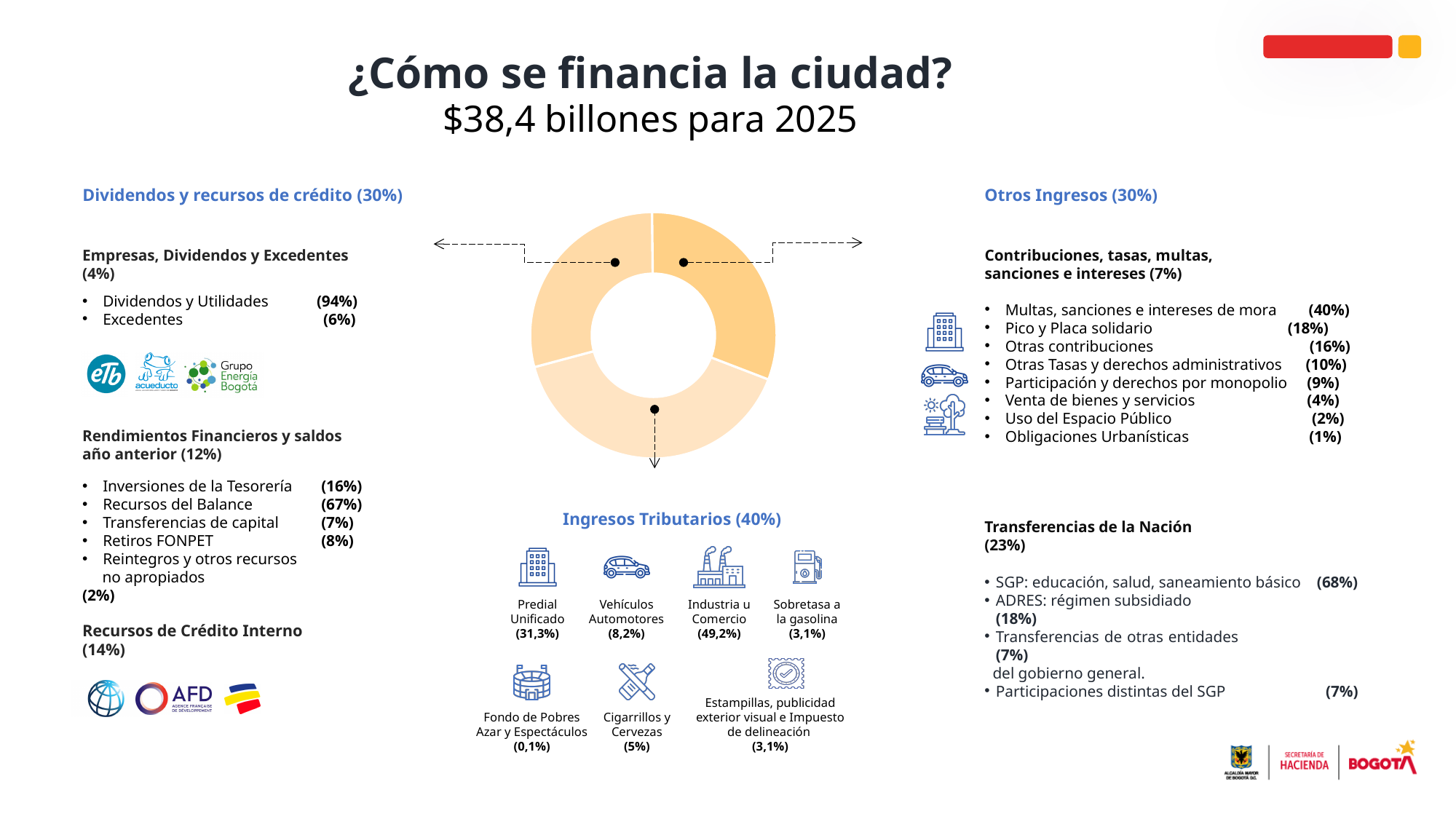
What is the title of the slide containing the donut chart? ¿Cómo se financia la ciudad? What kind of chart is shown in the centre of the slide? Pie chart (donut) How many slices does the donut chart have? 3 What share of the donut chart does Otros Ingresos represent? 30% Which slice of the donut chart is the largest? Ingresos Tributarios What share of the donut chart does Dividendos y recursos de crédito represent? 30% Which is larger in the donut chart, Ingresos Tributarios or Otros Ingresos? Ingresos Tributarios What total amount does the subtitle above the donut chart state for 2025? $38,4 billones Do the Otros Ingresos and Dividendos y recursos de crédito slices have the same share of the donut chart? Yes, both 30% What share of the donut chart does Ingresos Tributarios represent? 40% What is the difference in percentage points between the Ingresos Tributarios slice and the Dividendos y recursos de crédito slice? 10 percentage points